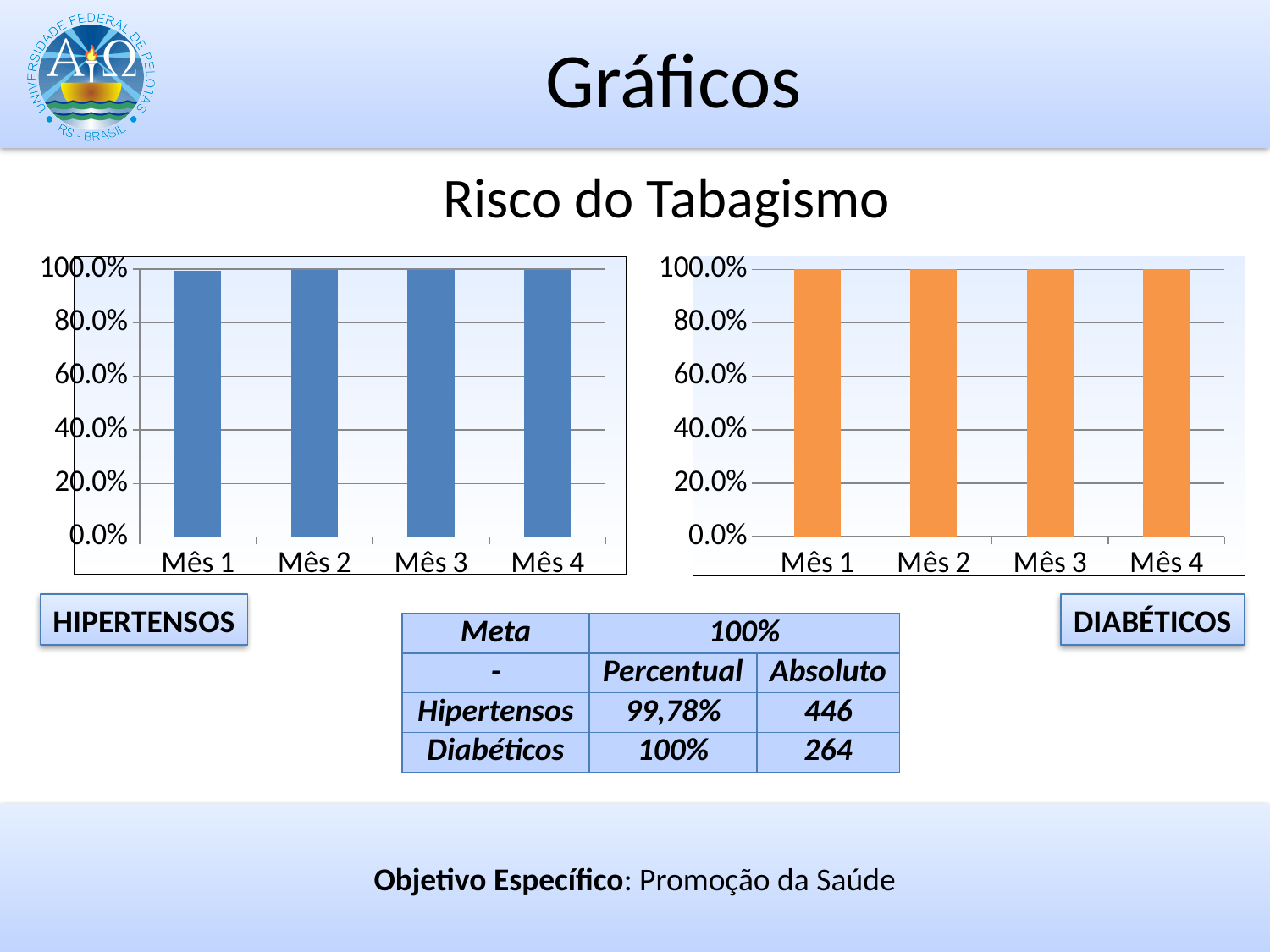
In the DIABÉTICOS chart, what value does the bar for Mês 1 reach? 100.0% How many categories are shown on the x axis of the HIPERTENSOS chart? 4 What is the shared title above the two charts? Risco do Tabagismo In the DIABÉTICOS chart, is the value for Mês 4 greater or less than 60.0%? greater What is the highest tick value shown on the y axis of the DIABÉTICOS chart? 100.0% What colour are the bars in the DIABÉTICOS chart? Orange What kind of chart is the DIABÉTICOS chart on the right? Bar chart What is the first category label on the x axis of the HIPERTENSOS chart? Mês 1 What kind of chart is the HIPERTENSOS chart on the left? Bar chart How many bars does the DIABÉTICOS chart have? 4 In the HIPERTENSOS chart, is the value for Mês 2 greater or less than 80.0%? greater In the DIABÉTICOS chart, what value does the bar for Mês 3 reach? 100.0%